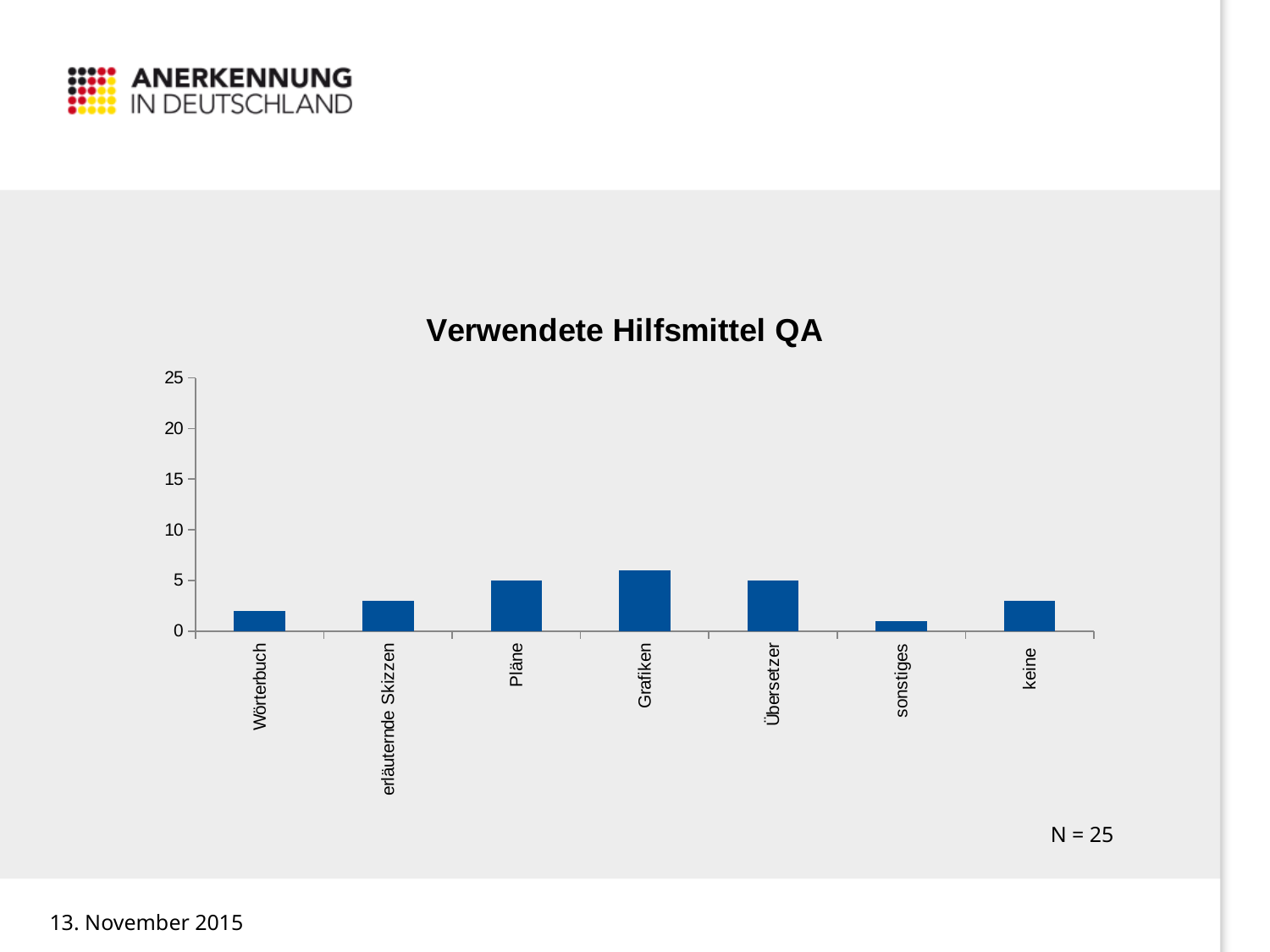
What kind of chart is shown on the slide? bar chart Which is larger, the value for Pläne or the value for sonstiges? Pläne Which is larger, the value for Grafiken or the value for Wörterbuch? Grafiken How many categories are shown on the x axis of the chart? 7 What is the value for Pläne in the chart? 5 Which category has the lowest bar in the chart? sonstiges What sample size (N) is stated below the chart? N = 25 Is the value for keine greater or less than 5? less Is the value for Grafiken greater or less than 10? less Is the value for Wörterbuch greater or less than 5? less Which category has the highest bar in the chart? Grafiken What is the title of the chart? Verwendete Hilfsmittel QA